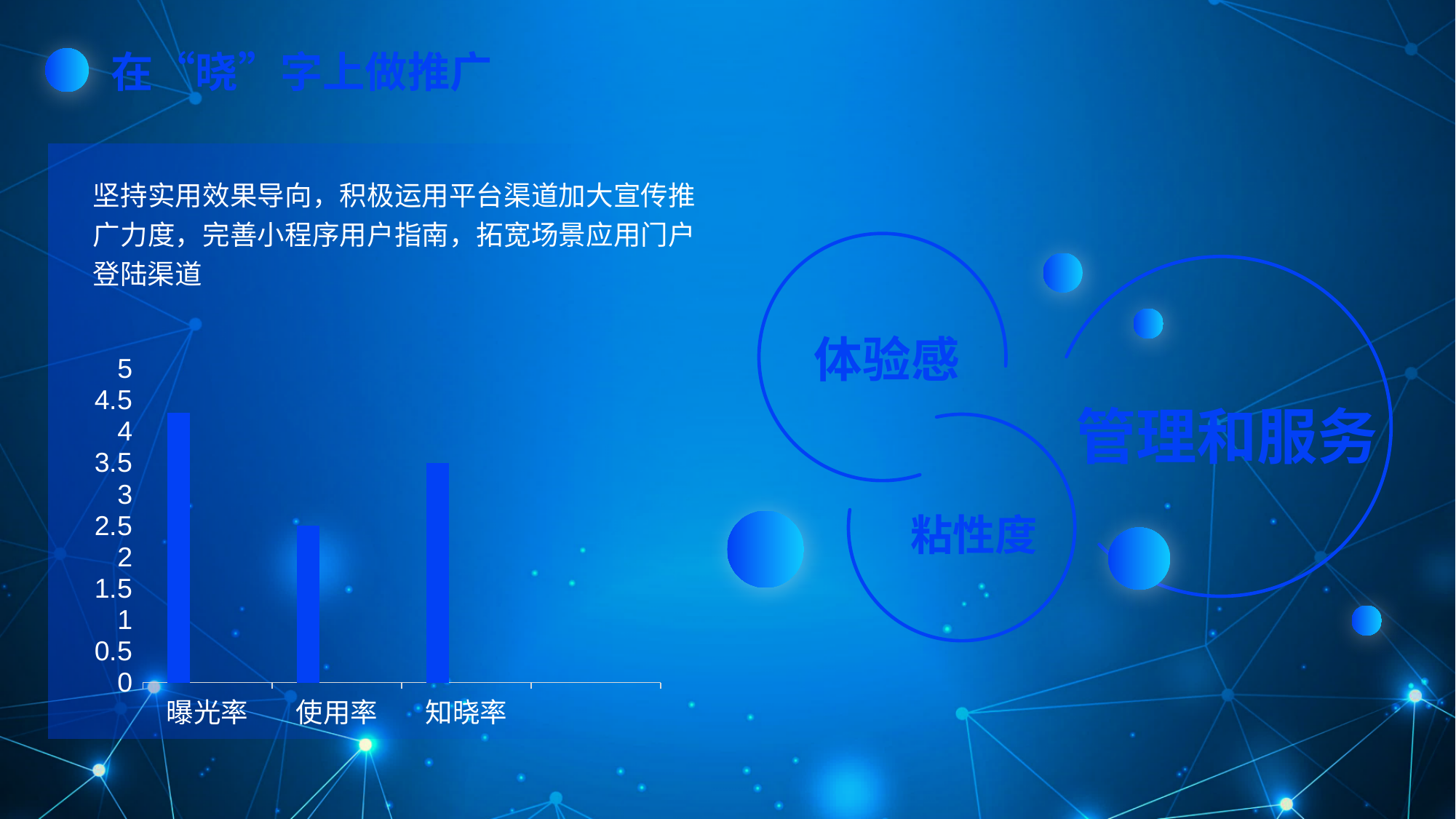
What kind of chart is shown on the slide? bar chart What is the highest value shown on the vertical axis of the chart? 5 Is the value for 知晓率 greater or less than 3? greater Which category has the lowest bar in the chart? 使用率 Which category has the highest bar in the chart? 曝光率 What are the category labels along the x axis of the chart, from left to right? 曝光率, 使用率, 知晓率 How many categories are plotted in the bar chart? 3 Is the value for 曝光率 greater or less than 4.5? less Is the value for 曝光率 greater or less than 4? greater Which is larger, the value for 使用率 or the value for 知晓率? 知晓率 Which is larger, the value for 曝光率 or the value for 知晓率? 曝光率